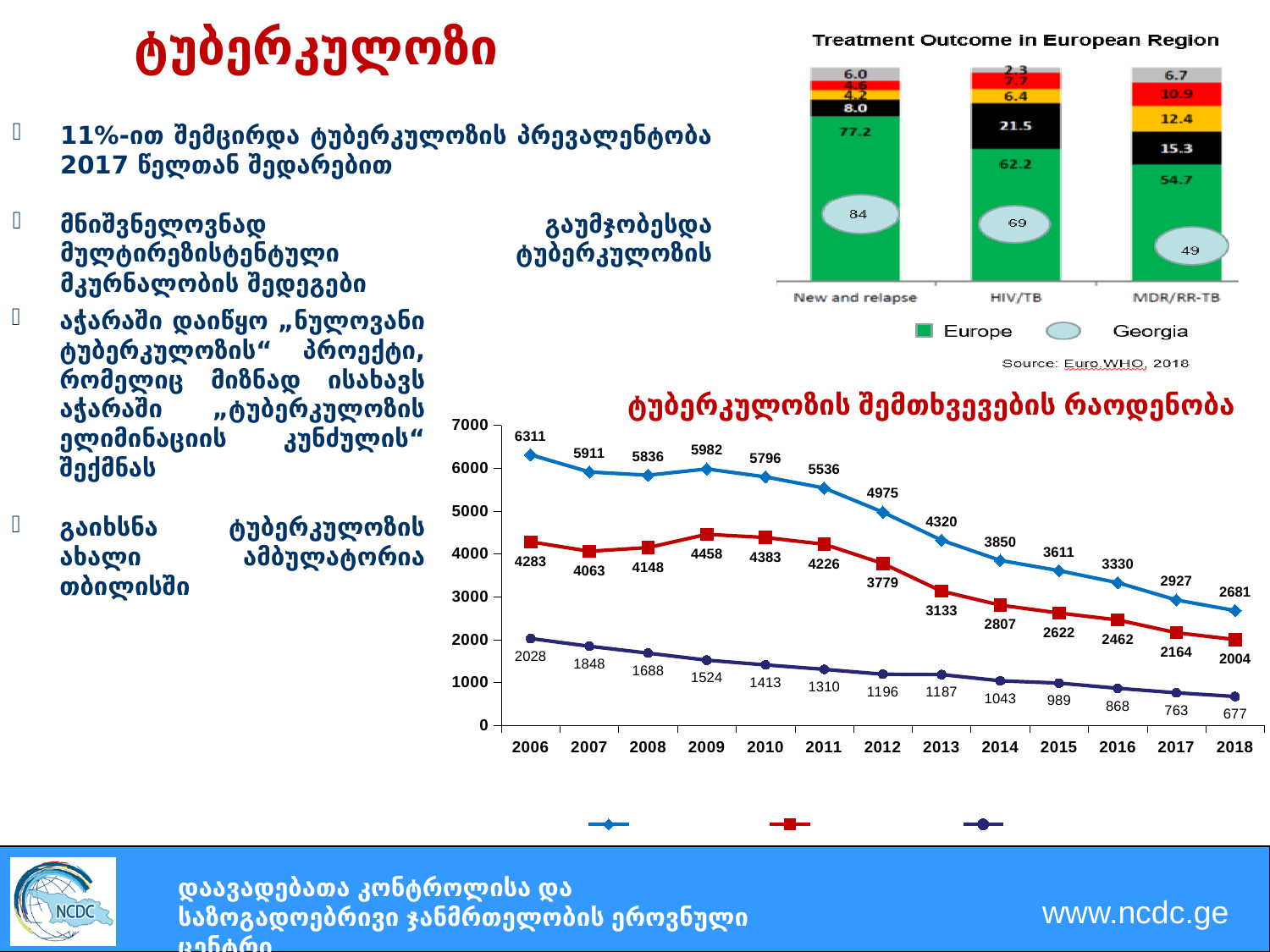
What kind of chart is 'Treatment Outcome in European Region'? stacked bar chart In the line chart titled 'ტუბერკულოზის შემთხვევების რაოდენობა', how many years are shown on the x axis? 13 In the line chart titled 'ტუბერკულოზის შემთხვევების რაოდენობა', in which year does the red series reach its lowest value? 2018 In the line chart titled 'ტუბერკულოზის შემთხვევების რაოდენობა', what is the difference between the blue series values in 2006 and 2018? 3630 In the line chart titled 'ტუბერკულოზის შემთხვევების რაოდენობა', does the dark blue series rise or fall from 2006 to 2018? fall In the line chart titled 'ტუბერკულოზის შემთხვევების რაოდენობა', how many series are plotted? 3 In the line chart titled 'ტუბერკულოზის შემთხვევების რაოდენობა', which is larger: the red series value in 2009 or in 2010? 2009 In the line chart titled 'ტუბერკულოზის შემთხვევების რაოდენობა', what is the value of the dark blue series in 2012? 1196 In the line chart titled 'ტუბერკულოზის შემთხვევების რაოდენობა', what is the value of the red series in 2018? 2004 In the line chart titled 'ტუბერკულოზის შემთხვევების რაოდენობა', in which year does the blue series reach its highest value? 2006 In the line chart titled 'ტუბერკულოზის შემთხვევების რაოდენობა', what is the value of the blue series in 2006? 6311 In the chart titled 'Treatment Outcome in European Region', what is the Georgia value for MDR/RR-TB? 49